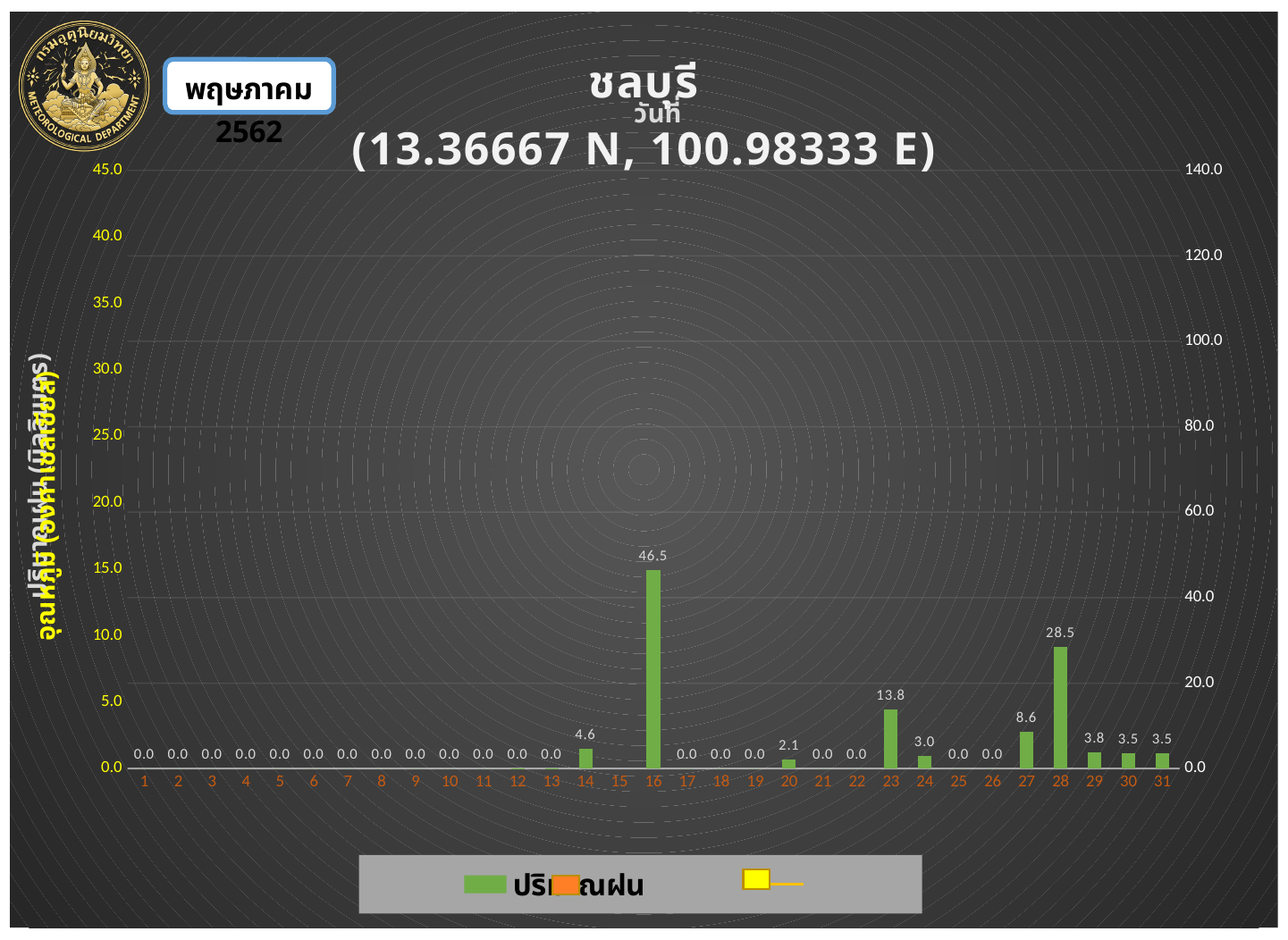
What is the difference between the rainfall values for day 29 and day 30? 0.3 What is the difference between the rainfall values for day 16 and day 28? 18.0 What is the title of the chart? ชลบุรี (13.36667 N, 100.98333 E) Which has a larger rainfall value, day 23 or day 27? day 23 Which day has the highest rainfall value? 16 What is the rainfall value for day 27? 8.6 What is the rainfall value for day 16? 46.5 What kind of chart is shown on the slide? bar chart What is the rainfall value for day 23? 13.8 How many days are shown on the x axis? 31 What is the rainfall value for day 20? 2.1 What is the rainfall value for day 28? 28.5